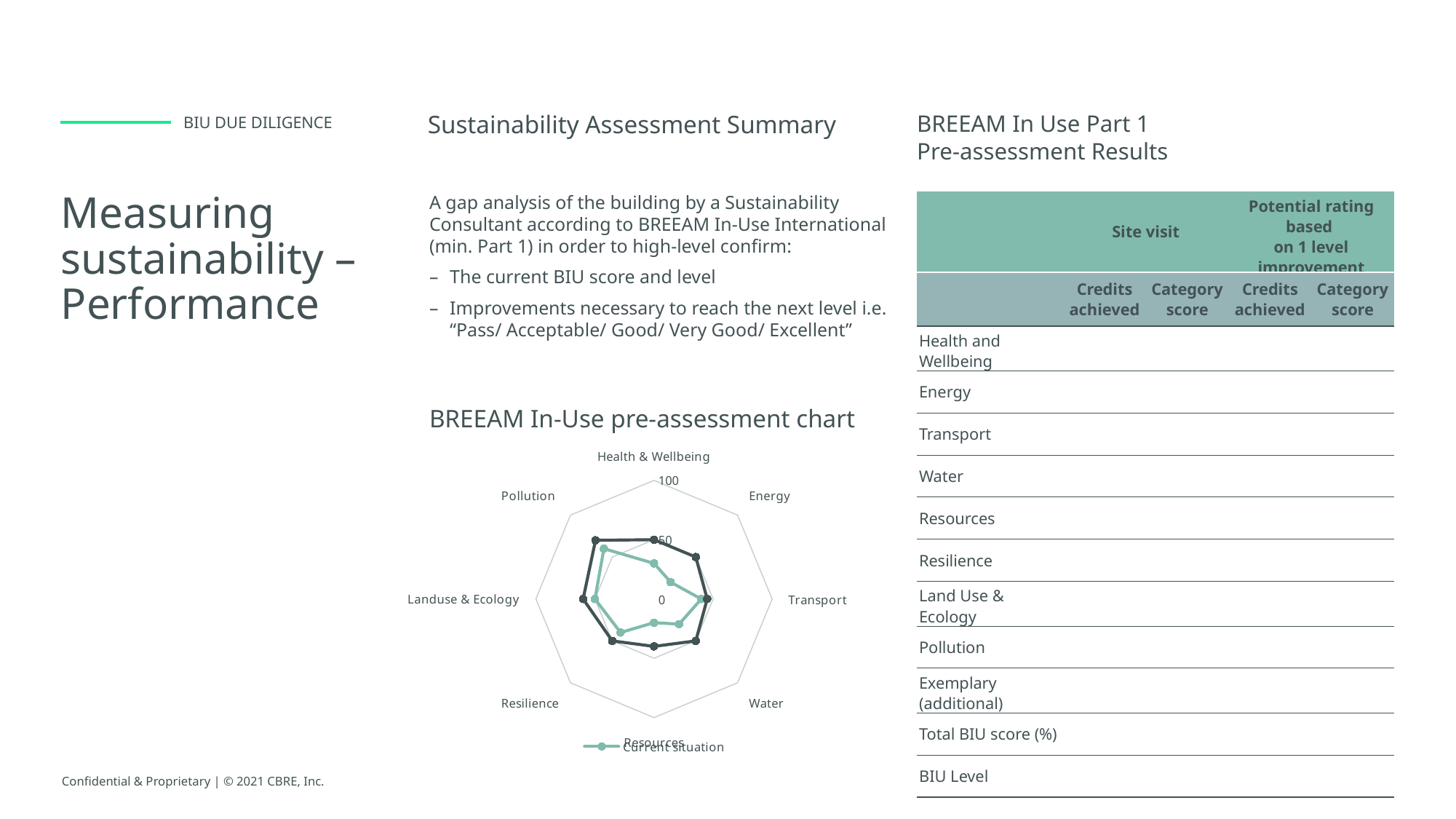
Is the Current situation value for Health & Wellbeing greater or less than 50? less What is the title of the chart on the slide? BREEAM In-Use pre-assessment chart Which category has the highest Current situation value on the BREEAM In-Use pre-assessment chart? Pollution What kind of chart is the BREEAM In-Use pre-assessment chart? Radar chart How many categories are plotted on the BREEAM In-Use pre-assessment chart? 8 Is the Current situation value for Water greater or less than 50? less For the Current situation series, which is larger: Pollution or Energy? Pollution Is the Current situation value for Energy greater or less than 50? less For the Current situation series, which is larger: Landuse & Ecology or Resources? Landuse & Ecology What is the highest value shown on the axis of the BREEAM In-Use pre-assessment chart? 100